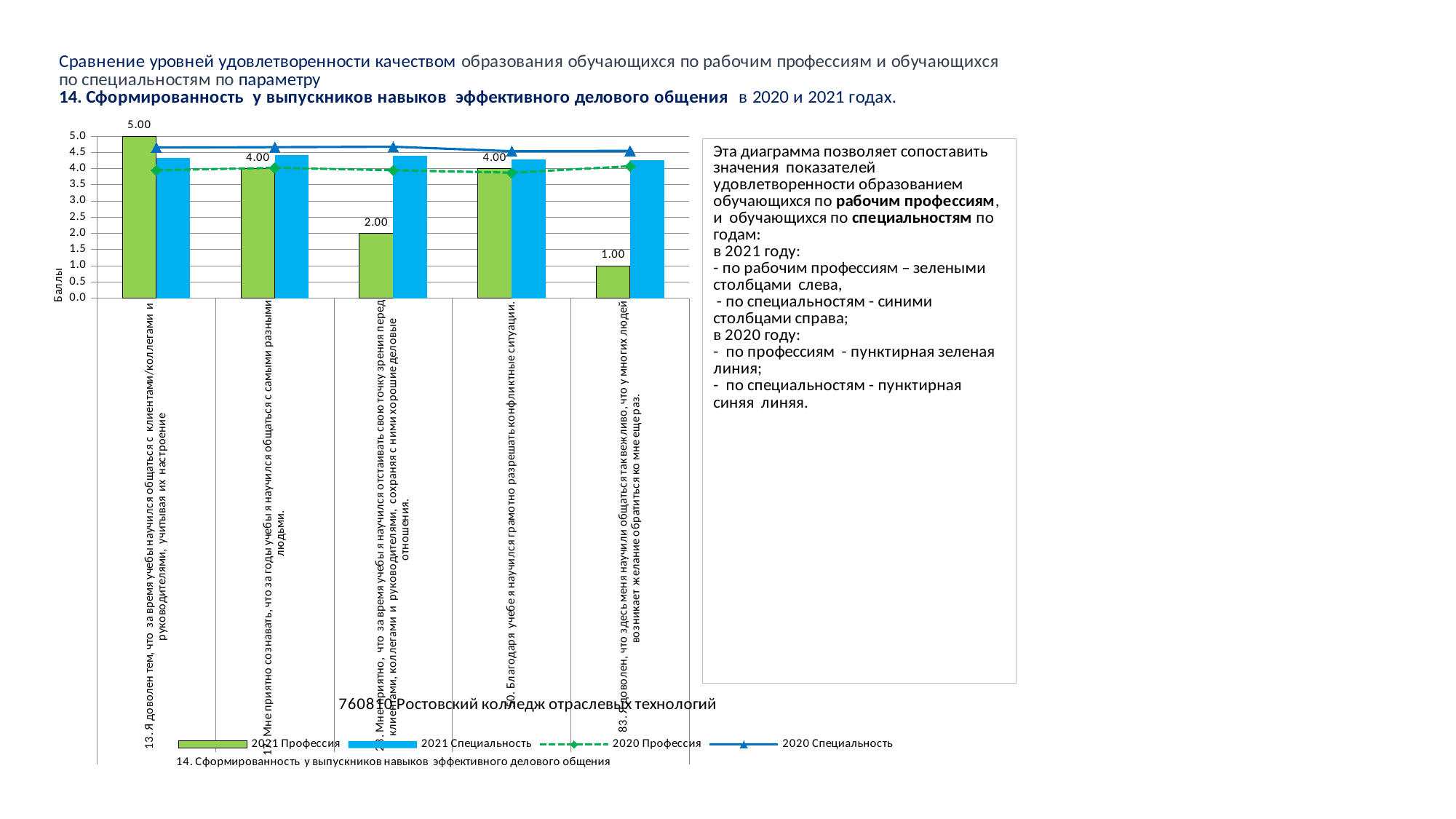
Which category has the lowest 2021 Профессия bar? 83. Я доволен, что здесь меня научили общаться так вежливо What is the value of the 2021 Профессия bar for category 13 (Я доволен тем, что за время учебы научился общаться с клиентами/коллегами и руководителями)? 5.00 How many categories are shown on the x axis of the chart? 5 Which category has the highest 2021 Профессия bar? 13. Я доволен тем, что за время учебы научился общаться с клиентами/коллегами и руководителями What is the title of the vertical axis of the chart? Баллы Is the 2021 Специальность bar for category 13 greater or less than 4.0? greater What is the difference between the 2021 Профессия values for category 13 and category 83? 4.00 What is the value of the 2021 Профессия bar for category 83 (Я доволен, что здесь меня научили общаться так вежливо)? 1.00 How many series does the chart legend list? 4 Which is larger: the 2021 Профессия value for category 13 or for category 50? Category 13 What kind of chart is used for the 2021 Профессия and 2021 Специальность series? Bar chart What is the value of the 2021 Профессия bar for category 50 (Благодаря учебе я научился грамотно разрешать конфликтные ситуации)? 4.00